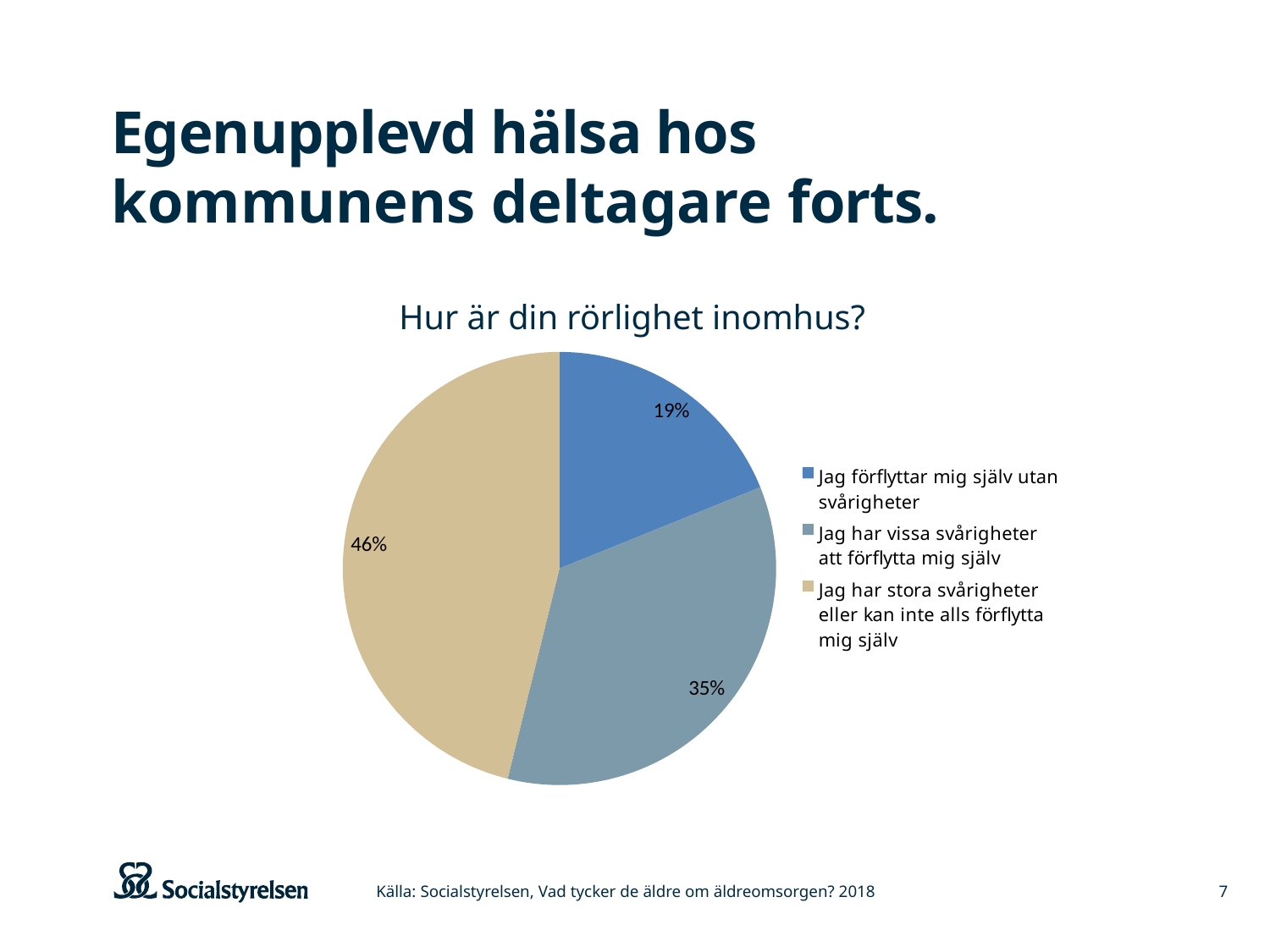
What share of the pie is labelled "Jag har stora svårigheter eller kan inte alls förflytta mig själv"? 46% What is the difference in percentage points between the largest and smallest slices? 27 What share of the pie is labelled "Jag förflyttar mig själv utan svårigheter"? 19% What share of the pie is labelled "Jag har vissa svårigheter att förflytta mig själv"? 35% What is the title of the chart? Hur är din rörlighet inomhus? How many categories does the pie chart have? 3 What kind of chart is shown on the slide? Pie chart Which is larger: the slice for "Jag har vissa svårigheter att förflytta mig själv" or the slice for "Jag förflyttar mig själv utan svårigheter"? Jag har vissa svårigheter att förflytta mig själv What is the difference in percentage points between "Jag har vissa svårigheter att förflytta mig själv" and "Jag förflyttar mig själv utan svårigheter"? 16 Which category has the smallest slice of the pie? Jag förflyttar mig själv utan svårigheter What colour is the slice for "Jag har stora svårigheter eller kan inte alls förflytta mig själv"? Beige Which category has the largest slice of the pie? Jag har stora svårigheter eller kan inte alls förflytta mig själv